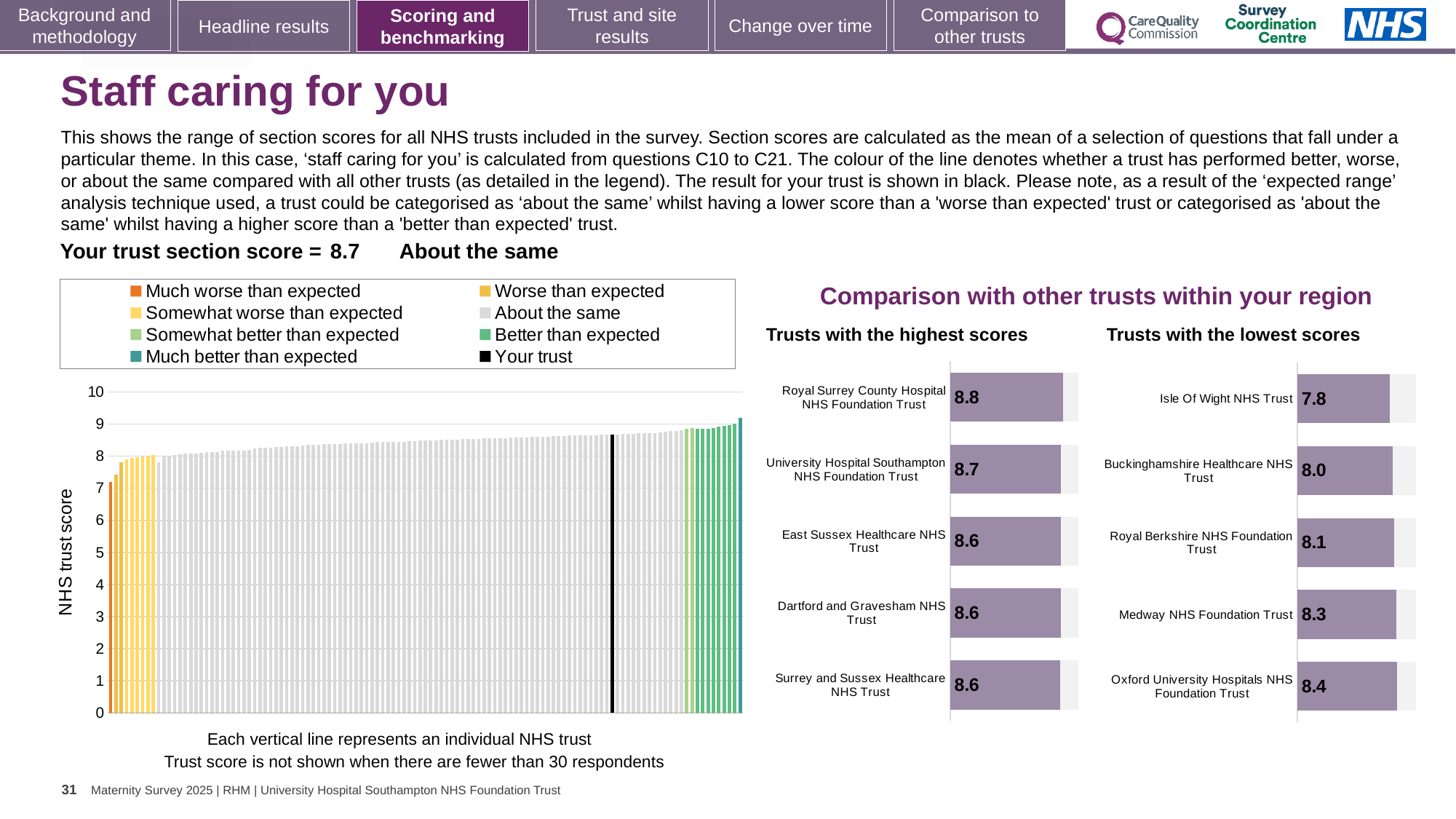
How many trusts are shown in the 'Trusts with the lowest scores' chart? 5 In the 'Trusts with the highest scores' chart, which trust has the highest score? Royal Surrey County Hospital NHS Foundation Trust In the main chart on the left showing all NHS trusts, do the values rise or fall from left to right along the x axis? rise In the 'Trusts with the lowest scores' chart, what is the score for Isle Of Wight NHS Trust? 7.8 In the 'Trusts with the highest scores' chart, what is the difference between the scores of Royal Surrey County Hospital NHS Foundation Trust and University Hospital Southampton NHS Foundation Trust? 0.1 In the 'Trusts with the lowest scores' chart, which trust has the lowest score? Isle Of Wight NHS Trust What type of chart is the 'Trusts with the highest scores' chart? Bar chart In the main chart on the left showing all NHS trusts, is the value for the black 'Your trust' line greater or less than 8? greater What is the y-axis label of the main chart on the left showing all NHS trusts? NHS trust score In the 'Trusts with the lowest scores' chart, what is the difference between the scores of Oxford University Hospitals NHS Foundation Trust and Isle Of Wight NHS Trust? 0.6 In the 'Trusts with the lowest scores' chart, which has the higher score: Medway NHS Foundation Trust or Buckinghamshire Healthcare NHS Trust? Medway NHS Foundation Trust In the 'Trusts with the highest scores' chart, what is the score for Royal Surrey County Hospital NHS Foundation Trust? 8.8